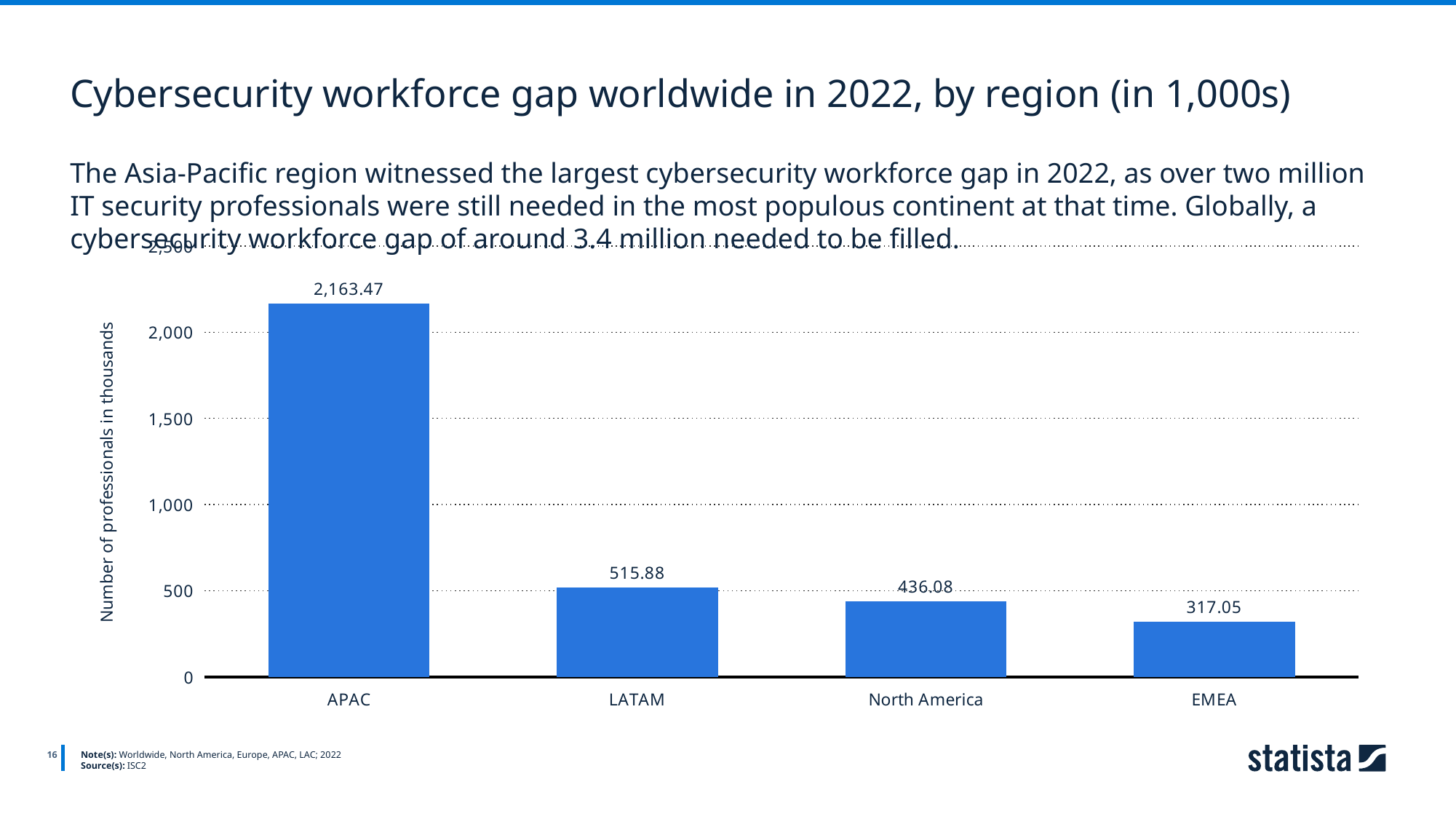
What is the difference between the workforce gap for APAC and LATAM? 1,647.59 Which region has the largest cybersecurity workforce gap? APAC What is the difference between the workforce gap for North America and EMEA? 119.03 What is the cybersecurity workforce gap for EMEA? 317.05 What is the cybersecurity workforce gap for APAC? 2,163.47 What is the cybersecurity workforce gap for LATAM? 515.88 Which region has a larger workforce gap, LATAM or North America? LATAM Which region has the smallest cybersecurity workforce gap? EMEA How many regions are shown in the chart? 4 What is the cybersecurity workforce gap for North America? 436.08 Is the value for APAC greater or less than 2,000? greater What type of chart is shown on the slide? Bar chart